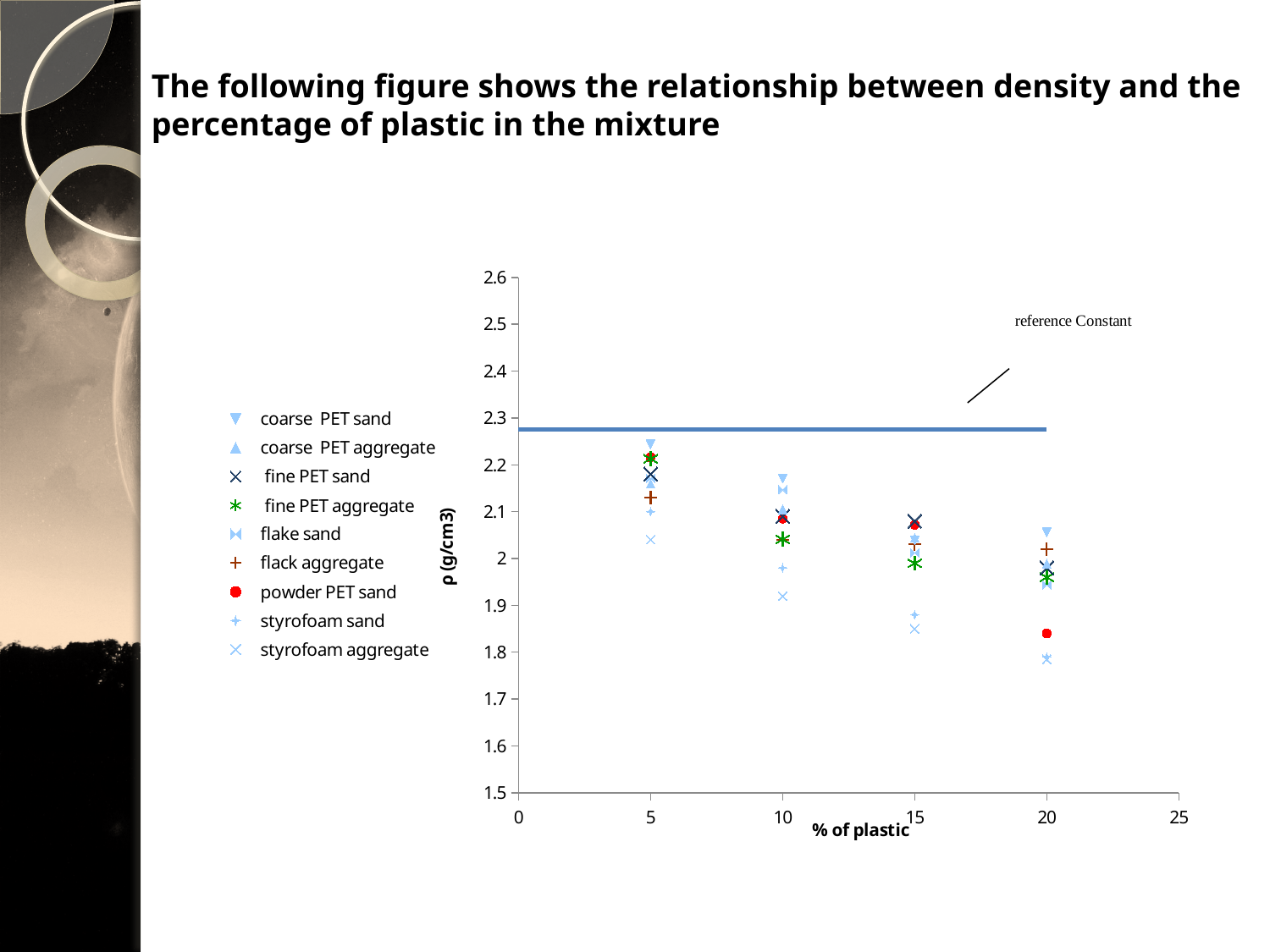
How many series does the chart's legend list? 9 Is the density of styrofoam aggregate at 10% plastic greater or less than 2? less At how many different percentages of plastic are data points plotted? 4 Is the density of coarse PET sand at 5% plastic greater or less than 2.2? greater Is the reference constant line greater or less than 2.3? less What kind of chart is shown on the slide? scatter chart What is the label of the y axis of the chart? ρ (g/cm3) At 20% plastic, which has the higher density: powder PET sand or coarse PET sand? coarse PET sand As the percentage of plastic increases, do the density values generally rise or fall? fall What is the label of the x axis of the chart? % of plastic